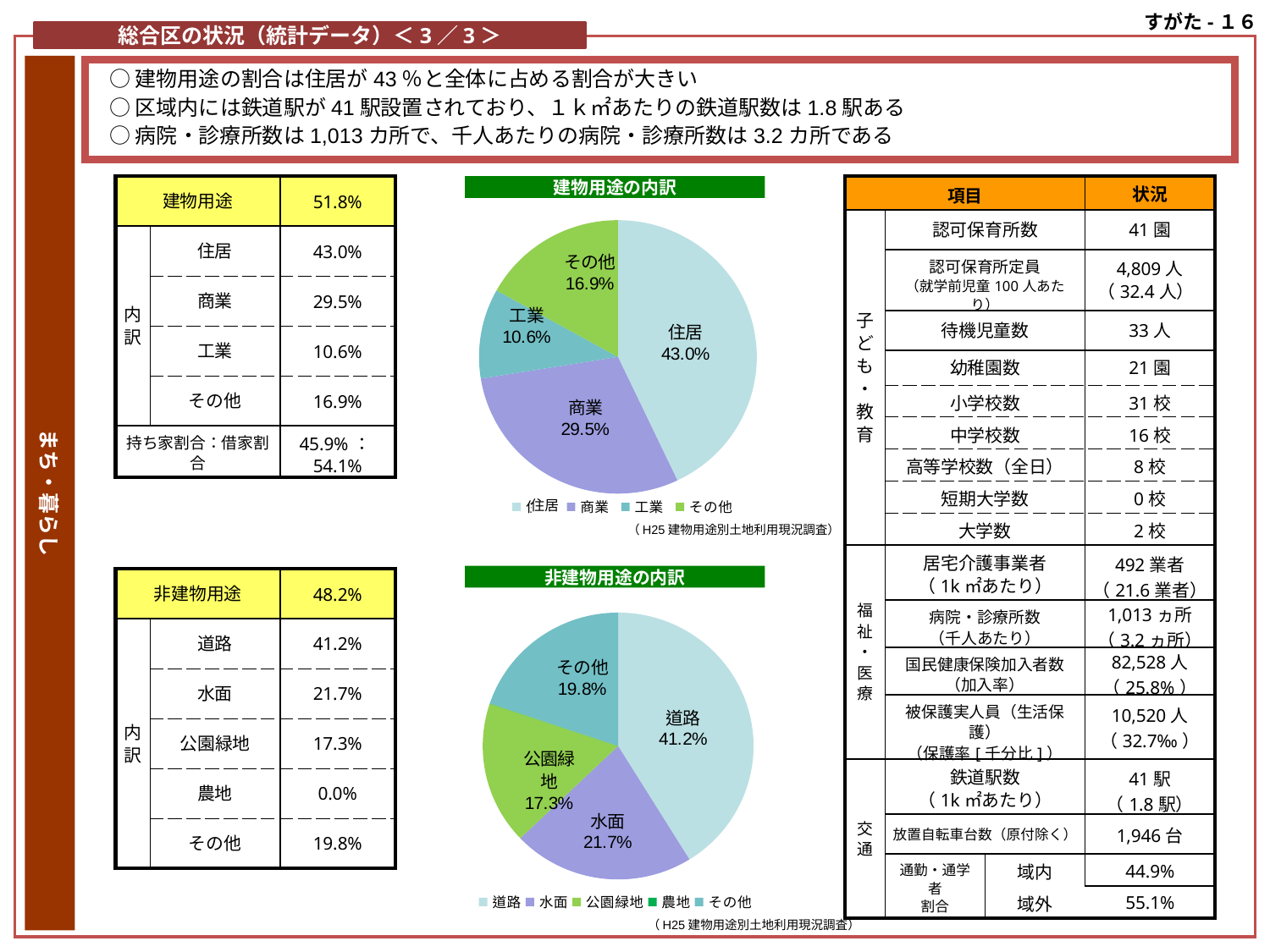
In the 非建物用途の内訳 chart, what is the value for 公園緑地? 17.3% In the 非建物用途の内訳 chart, which category has the largest share? 道路 In the 非建物用途の内訳 chart, which is larger, その他 or 公園緑地? その他 In the 建物用途の内訳 chart, what is the value for 工業? 10.6% In the 建物用途の内訳 chart, how many categories does the legend list? 4 What kind of chart is the 非建物用途の内訳 chart? pie chart In the 非建物用途の内訳 chart, how many categories does the legend list? 5 In the 建物用途の内訳 chart, which category has the largest share? 住居 In the 非建物用途の内訳 chart, what is the value for 水面? 21.7% In the 建物用途の内訳 chart, what is the value for 住居? 43.0% In the 建物用途の内訳 chart, what is the difference between 住居 and 商業? 13.5% In the 建物用途の内訳 chart, which category has the smallest share? 工業